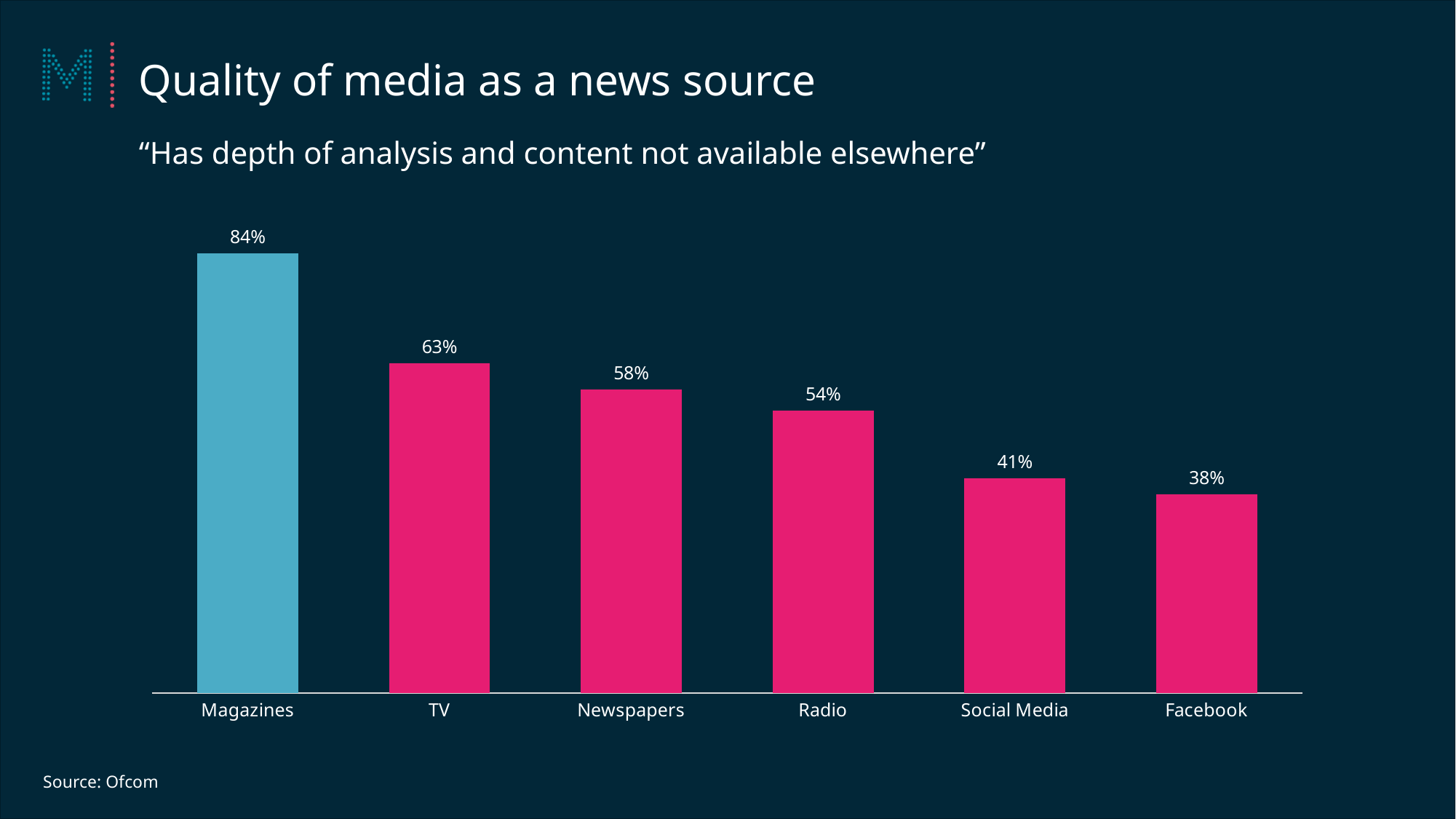
Do the values rise or fall from left to right along the x axis? Fall Which category has the highest value? Magazines What is the value for Magazines? 84% What is the difference between the values for Newspapers and Facebook? 20% What kind of chart is shown on the slide? Bar chart What is the difference between the values for Magazines and TV? 21% Which category has the lowest value? Facebook How many categories are shown on the chart? 6 What is the value for Social Media? 41% Which category's bar is coloured differently from the others? Magazines What is the value for Radio? 54% Which is larger, the value for TV or the value for Newspapers? TV